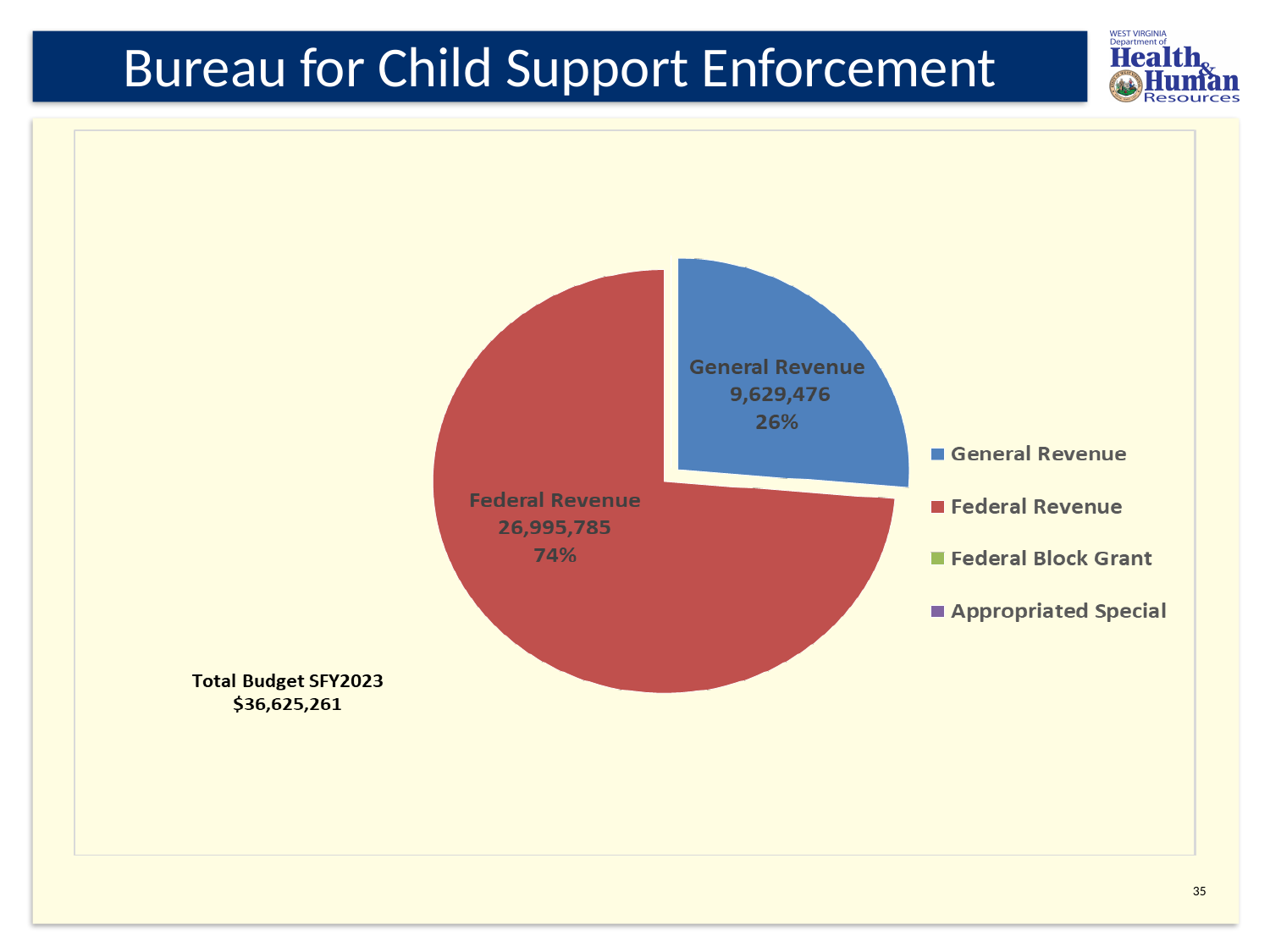
What is the value for Federal Revenue? 26,995,785 What is the difference between Federal Revenue and General Revenue? 17,366,309 How many entries does the legend list? 4 What type of chart is shown on the slide? pie chart What colour is the Federal Revenue slice? red What is the Total Budget SFY2023 shown on the slide? $36,625,261 Which is larger, Federal Revenue or General Revenue? Federal Revenue Which category has the largest slice of the pie? Federal Revenue What is the value for General Revenue? 9,629,476 What share of the pie does Federal Revenue represent? 74% How many slices are visible in the pie? 2 What share of the pie does General Revenue represent? 26%